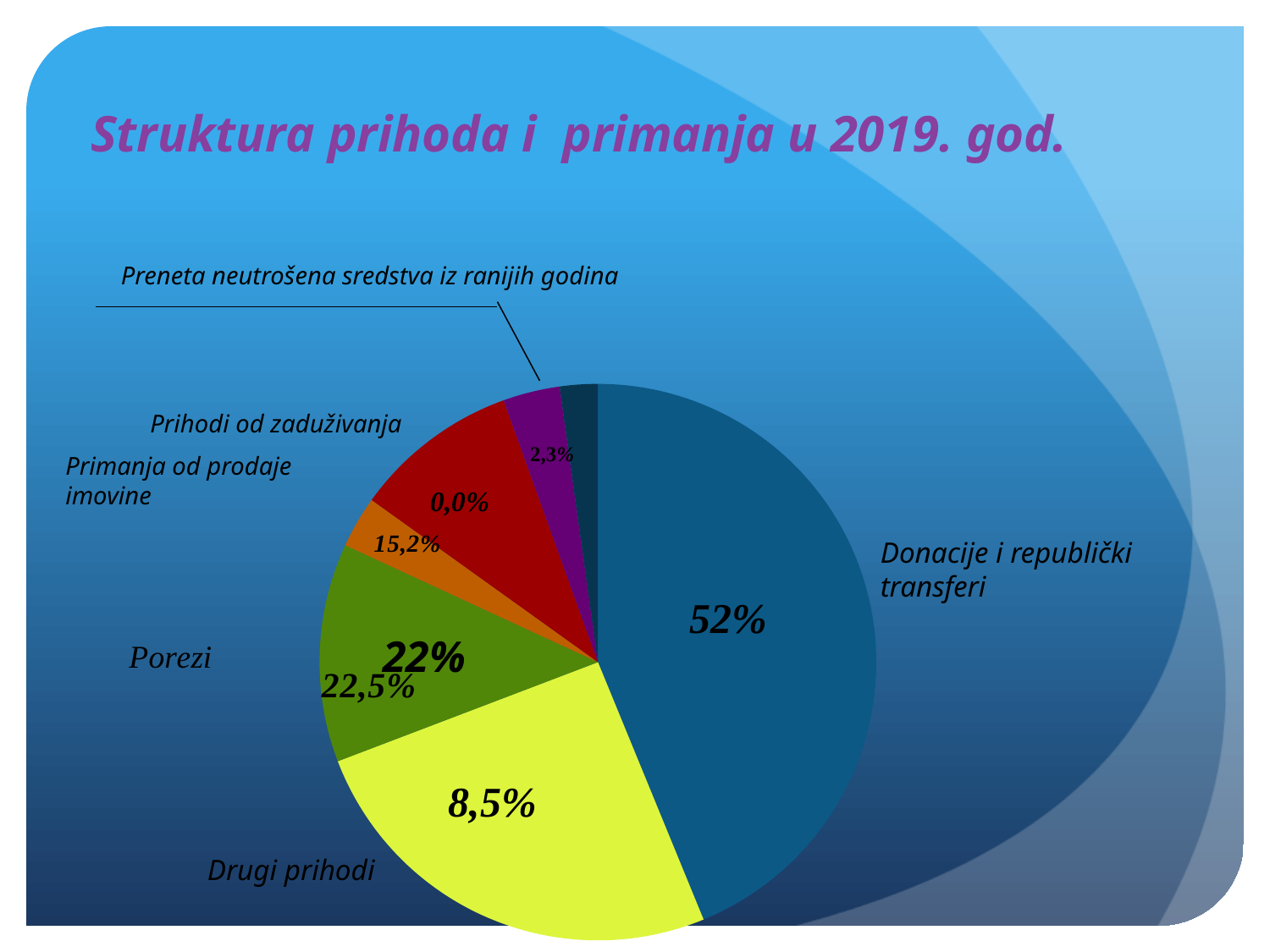
What percentage label is printed on the purple slice? 2,3% What percentage label is printed on the yellow slice? 8,5% Which slice is larger, Donacije i republički transferi or Drugi prihodi? Donacije i republički transferi What share of the pie is labelled for Donacije i republički transferi? 52% Which category label is connected to its slice by a leader line? Preneta neutrošena sredstva iz ranijih godina What kind of chart is shown on the slide? pie chart How many slices does the pie chart have? 7 Which category has the largest slice of the pie? Donacije i republički transferi What is the title of the chart on the slide? Struktura prihoda i primanja u 2019. god.